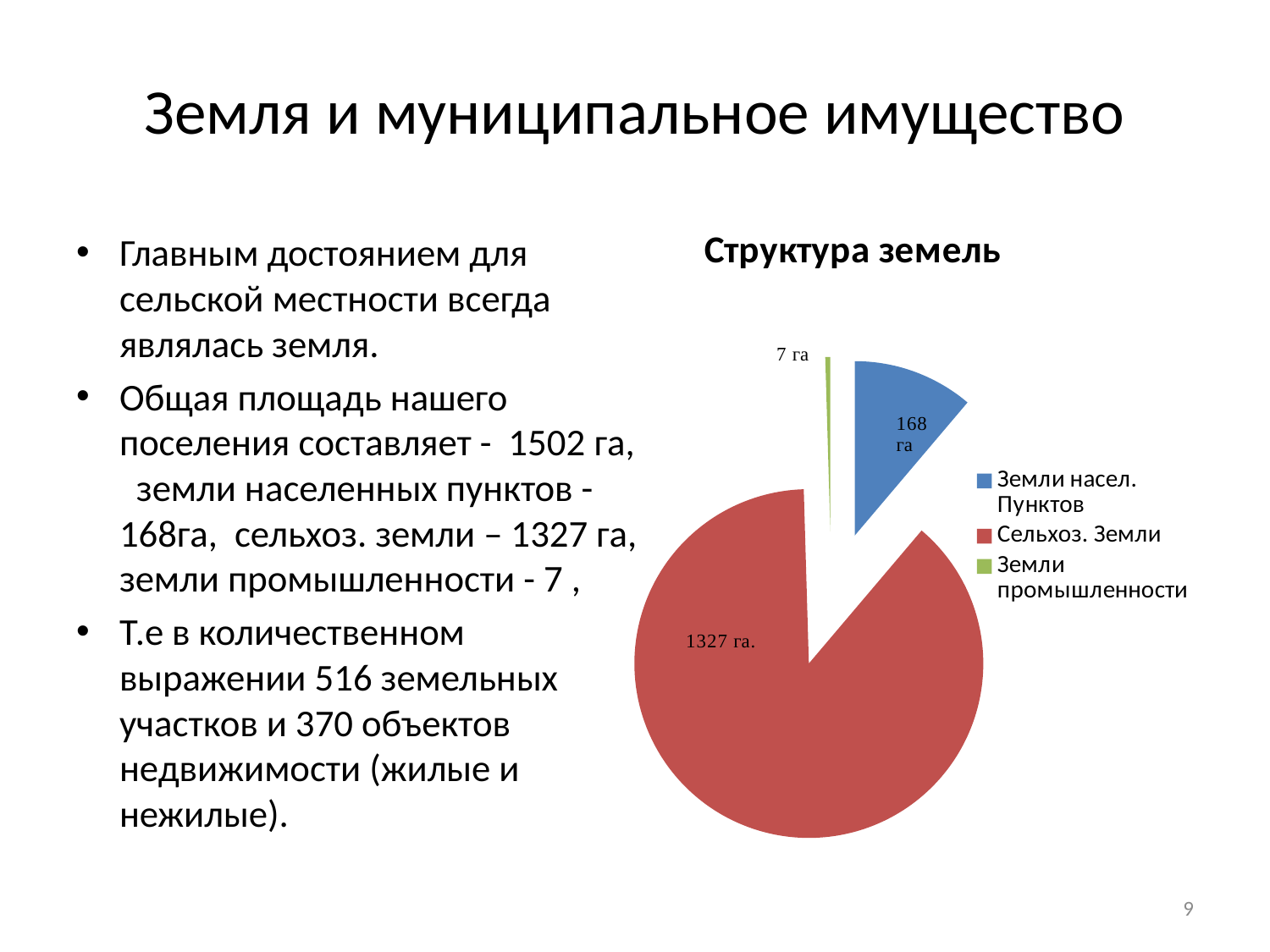
What is the difference between the values for "Сельхоз. Земли" and "Земли насел. Пунктов"? 1159 га What type of chart is shown under the title "Структура земель"? pie chart How many entries does the legend of the pie chart list? 3 What is the title of the pie chart? Структура земель Which is larger in the pie chart: "Земли насел. Пунктов" or "Земли промышленности"? Земли насел. Пунктов Which category has the largest slice in the pie chart? Сельхоз. Земли What is the value for "Земли насел. Пунктов" in the pie chart? 168 га Which category has the smallest slice in the pie chart? Земли промышленности What is the difference between the values for "Земли насел. Пунктов" and "Земли промышленности"? 161 га How many categories does the pie chart show? 3 What is the value for "Сельхоз. Земли" in the pie chart? 1327 га. What is the value for "Земли промышленности" in the pie chart? 7 га